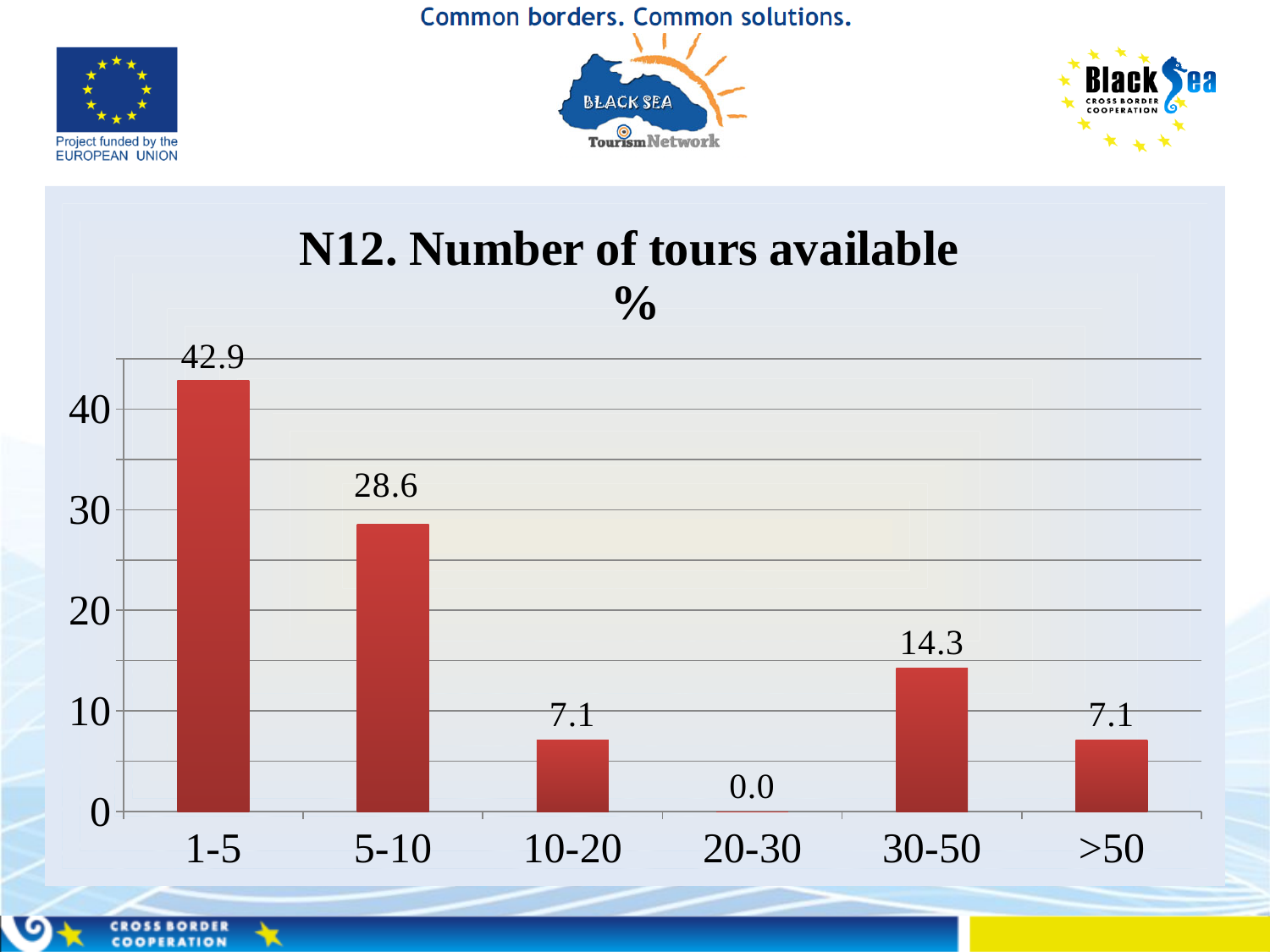
What is the title of the chart? N12. Number of tours available % How many categories are shown on the x axis? 6 Which category has the highest value? 1-5 Which category has the lowest value? 20-30 What kind of chart is shown on the slide? bar chart What is the value for the 30-50 category? 14.3 What is the value for the 5-10 category? 28.6 What is the value for the 20-30 category? 0.0 Which is larger, the value for 10-20 or the value for 30-50? 30-50 What is the value for the 1-5 category? 42.9 Is the value for 5-10 greater or less than 30? less What is the difference between the values for 1-5 and 5-10? 14.3